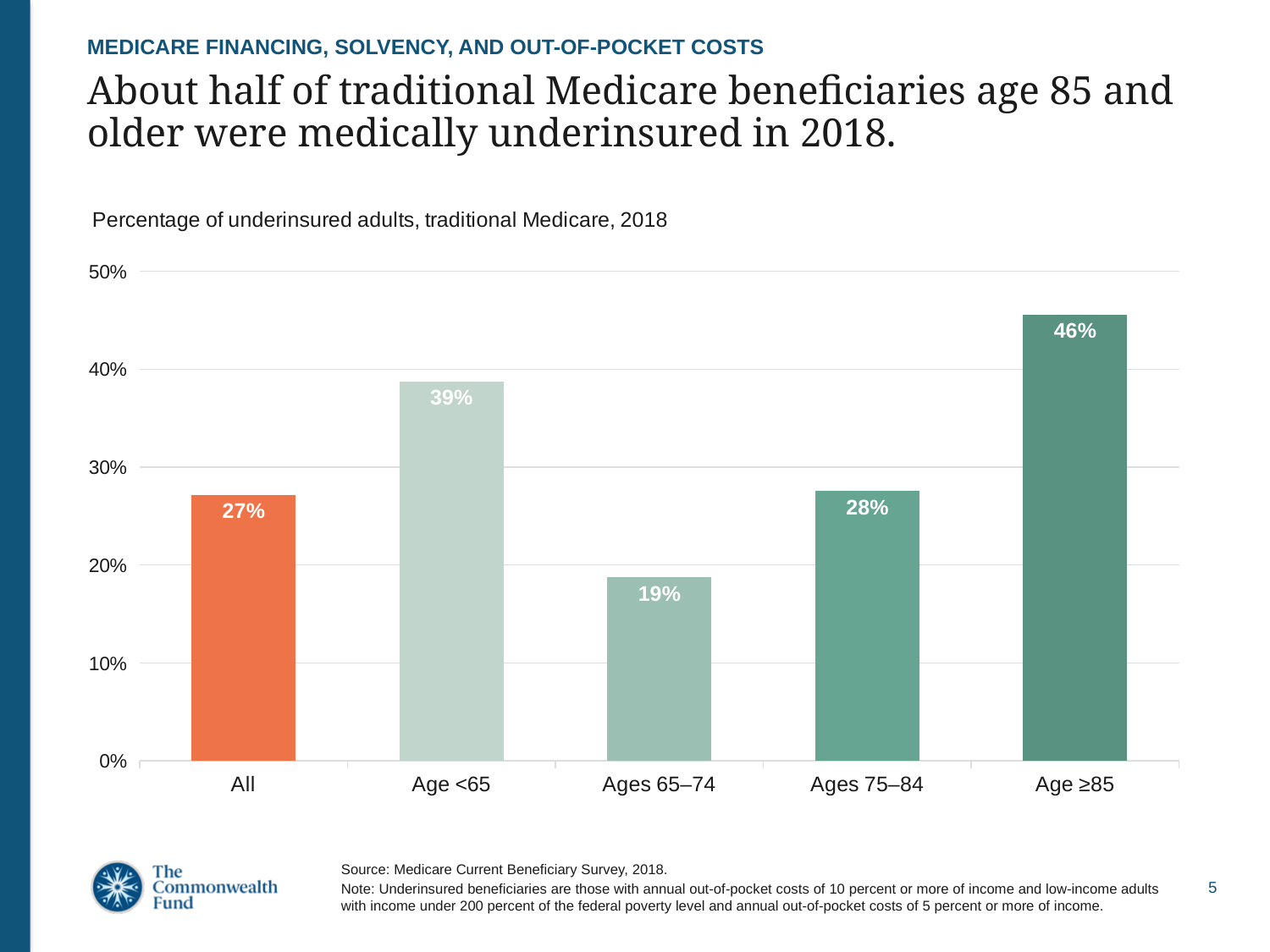
What kind of chart is shown on the slide? Bar chart What is the difference in percentage points between Age ≥85 and Ages 65–74? 27 What is the percentage of underinsured adults for Ages 65–74? 19% How many categories are shown on the x axis of the chart? 5 Which has a higher percentage of underinsured adults, Age <65 or Ages 75–84? Age <65 What is the subtitle of the chart? Percentage of underinsured adults, traditional Medicare, 2018 Which age group has the lowest percentage of underinsured adults? Ages 65–74 What is the percentage of underinsured adults for the Age ≥85 group? 46% Is the value for Age ≥85 greater or less than 40%? greater What is the difference in percentage points between Age <65 and Ages 75–84? 11 Which age group has the highest percentage of underinsured adults? Age ≥85 What is the percentage of underinsured adults for the All category? 27%